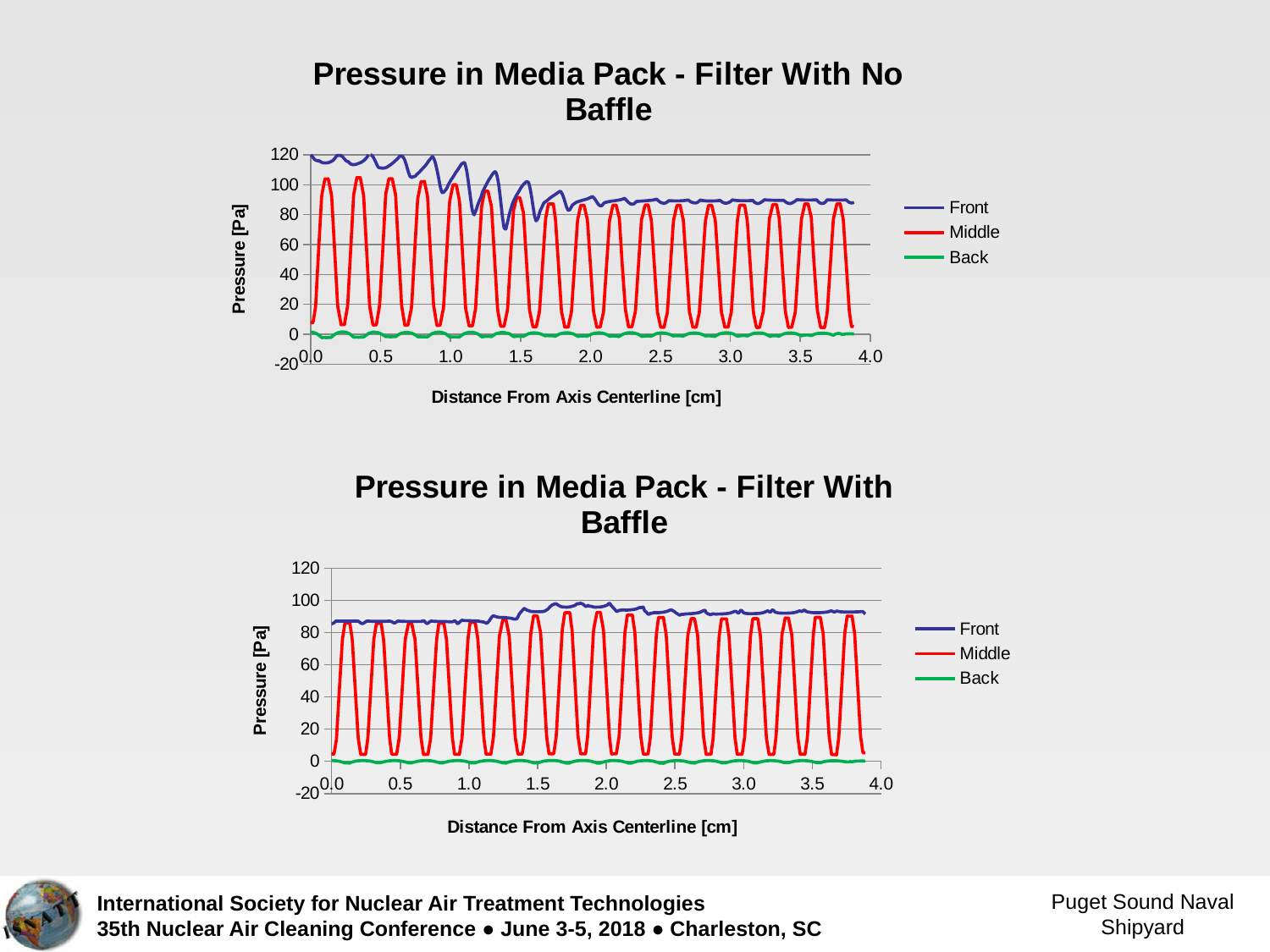
In the 'Pressure in Media Pack - Filter With No Baffle' chart, is the Front value at 3.5 cm greater or less than 100? less In the 'Pressure in Media Pack - Filter With Baffle' chart, is the Front value at 0.5 cm greater or less than 100? less What is the x-axis title of the 'Pressure in Media Pack - Filter With Baffle' chart? Distance From Axis Centerline [cm] In the 'Pressure in Media Pack - Filter With No Baffle' chart, does the Front series generally rise or fall as distance increases from 0.0 to 4.0 cm? fall How many series does the legend of the 'Pressure in Media Pack - Filter With Baffle' chart list? 3 In the 'Pressure in Media Pack - Filter With Baffle' chart, is the Front value at 2.0 cm greater or less than 80? greater What kind of chart is the 'Pressure in Media Pack - Filter With No Baffle' chart? line chart In the 'Pressure in Media Pack - Filter With No Baffle' chart, which is larger at 0.0 cm: the Front value or the Back value? Front In the 'Pressure in Media Pack - Filter With No Baffle' chart, what are the three series named in the legend? Front, Middle, Back In the 'Pressure in Media Pack - Filter With No Baffle' chart, which series has the lowest values across the whole distance range? Back